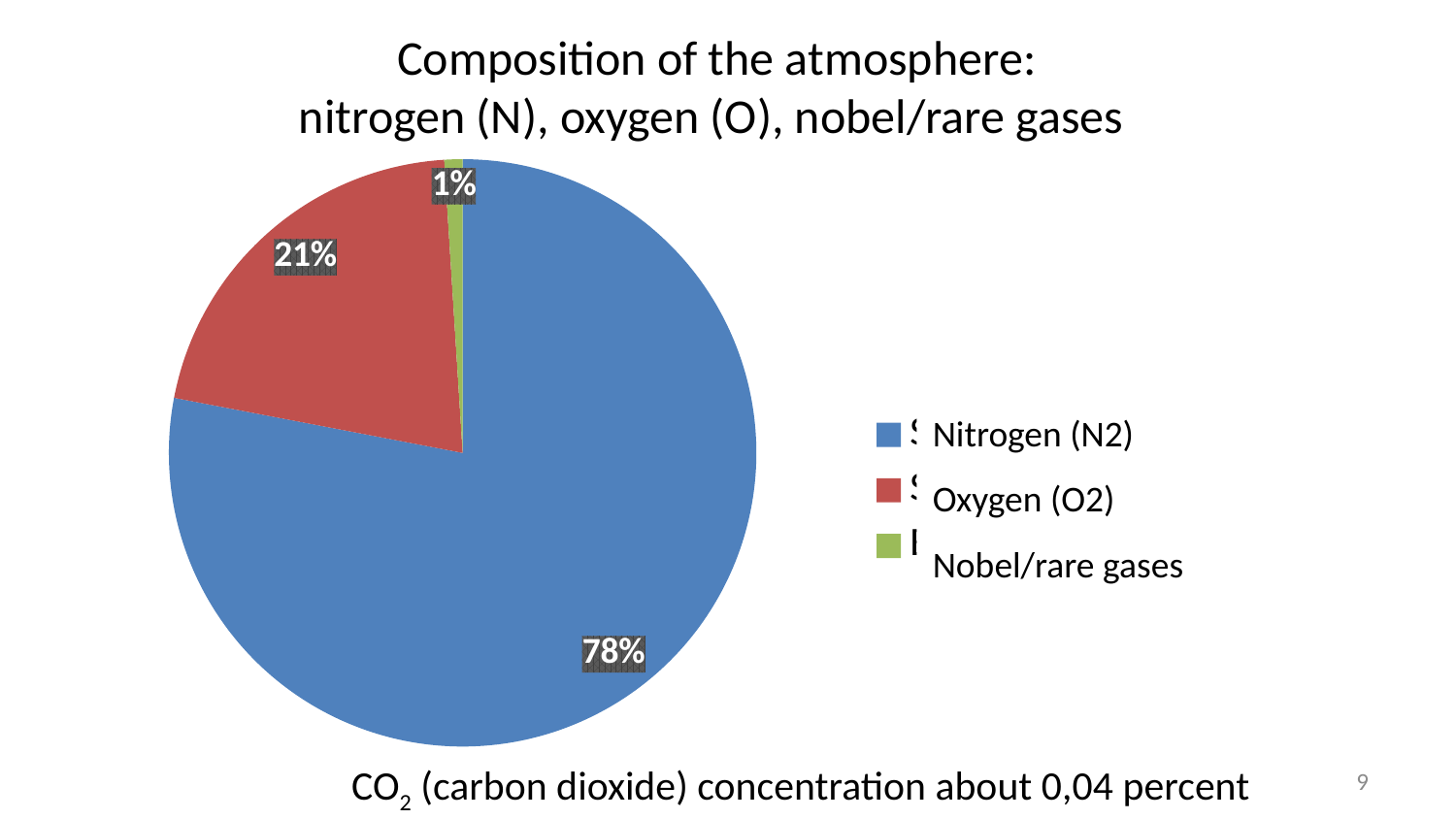
Which is larger, the Oxygen (O2) slice or the Nobel/rare gases slice? Oxygen (O2) How many slices does the pie chart have? 3 What colour is the Nitrogen (N2) slice? blue Which category has the smallest slice of the pie? Nobel/rare gases What colour is the Oxygen (O2) slice? red What kind of chart is shown on the slide? pie chart What share of the pie do Nobel/rare gases take? 1% What is the difference in percentage points between the Nitrogen (N2) and Oxygen (O2) slices? 57 What share of the pie does Oxygen (O2) take? 21% Which category has the largest slice of the pie? Nitrogen (N2) What share of the pie does Nitrogen (N2) take? 78% What is the difference in percentage points between the Oxygen (O2) and Nobel/rare gases slices? 20